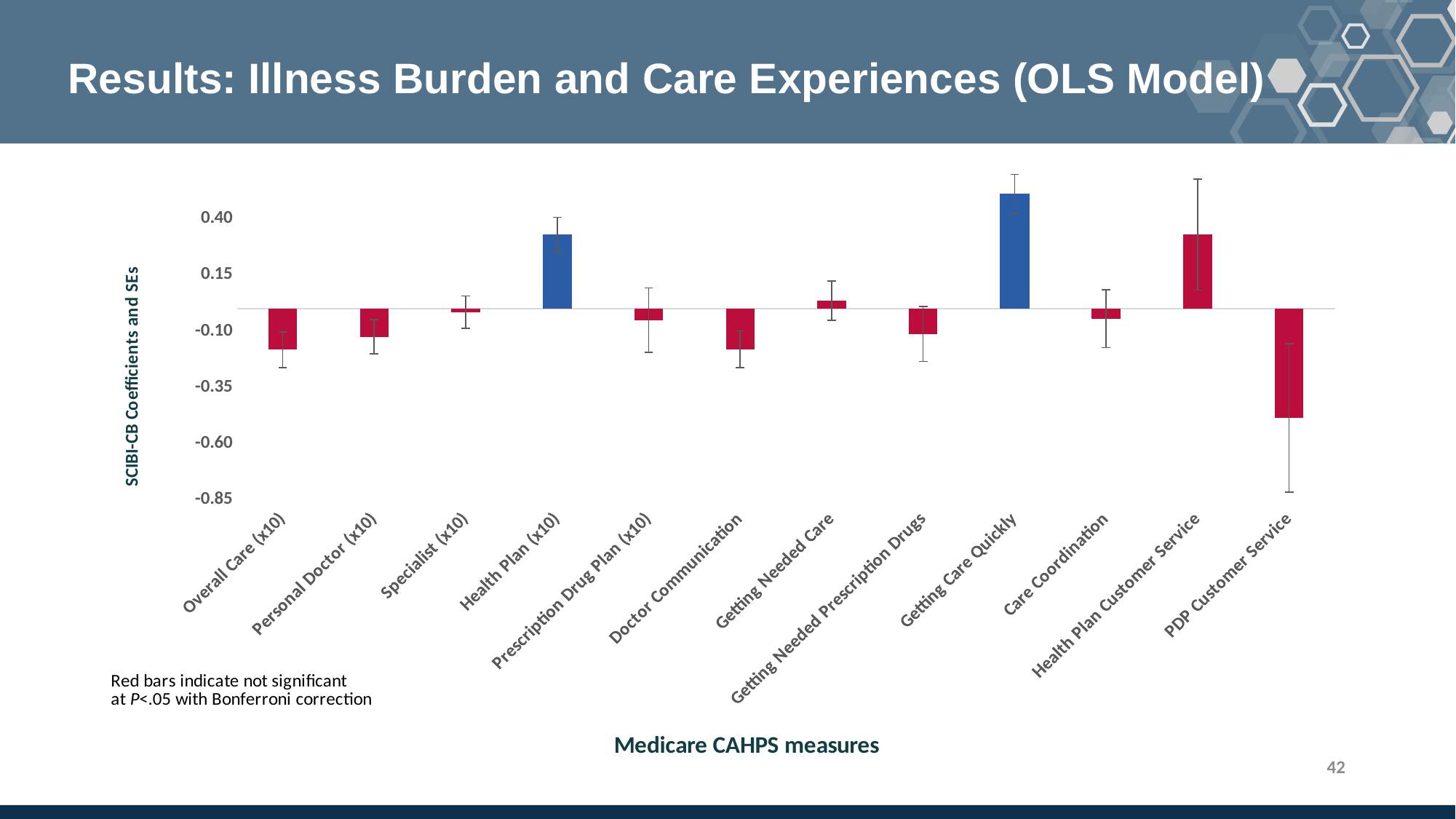
Is the coefficient for Getting Care Quickly greater or less than 0.40? greater Is the coefficient for Health Plan (x10) greater or less than 0.40? less Which Medicare CAHPS measure has the highest SCIBI-CB coefficient? Getting Care Quickly How many Medicare CAHPS measures (categories) are plotted on the x axis? 12 How many bars in the chart are blue? 2 Which has the larger coefficient, Getting Care Quickly or Health Plan (x10)? Getting Care Quickly Which Medicare CAHPS measure has the lowest SCIBI-CB coefficient? PDP Customer Service Is the coefficient for PDP Customer Service greater or less than -0.35? less What is the title of the x axis? Medicare CAHPS measures What kind of chart is shown on the slide? Bar chart Which has the larger coefficient, Specialist (x10) or Overall Care (x10)? Specialist (x10)